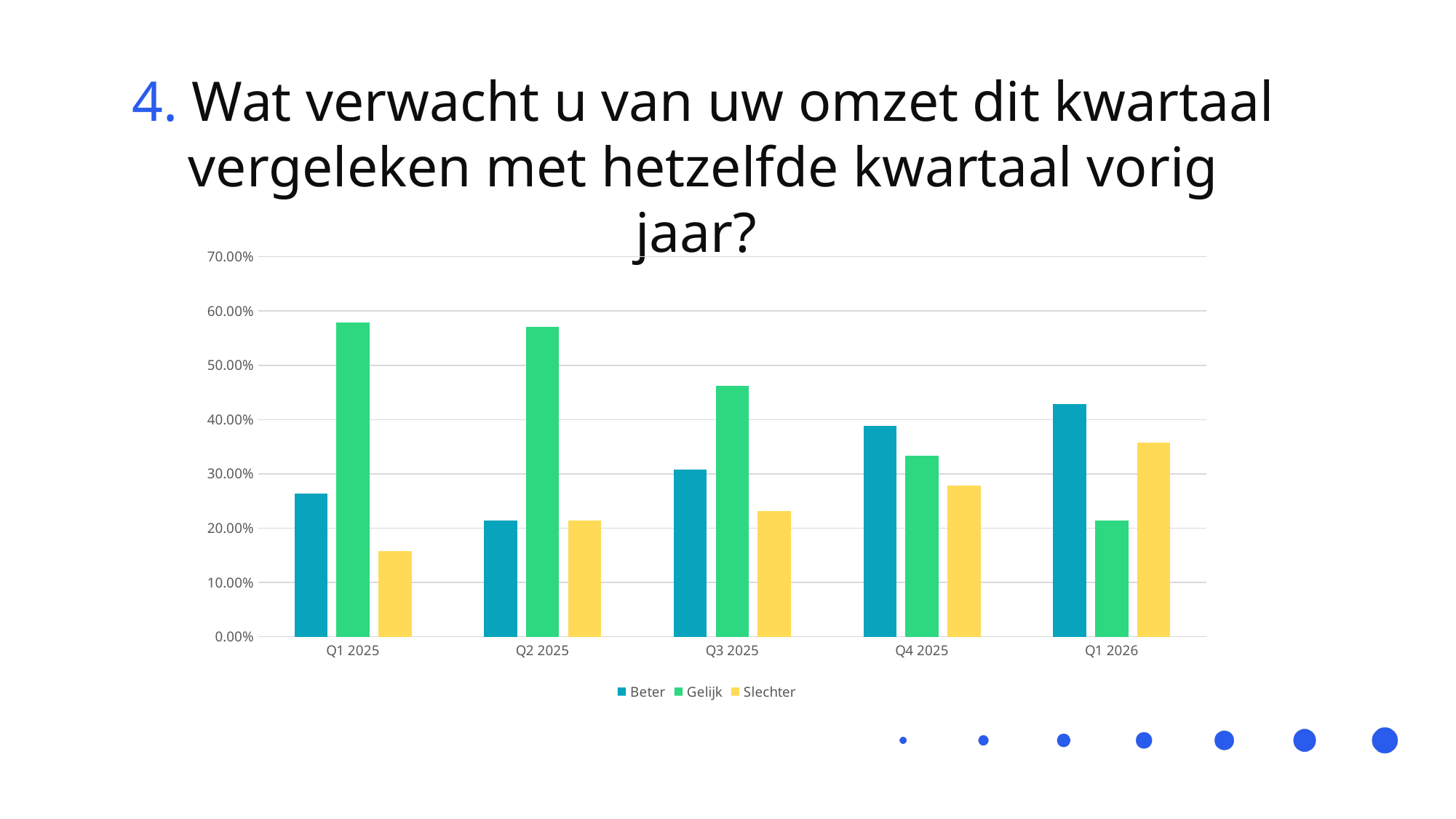
How many series does the chart's legend list? 3 In Q4 2025, which is larger: Beter or Gelijk? Beter Is the value for Gelijk in Q1 2025 greater or less than 50.00%? greater Which series has the lowest value in Q1 2025? Slechter What kind of chart is shown on the slide? bar chart What are the three entries in the chart's legend? Beter, Gelijk, Slechter Is the value for Beter in Q1 2026 greater or less than 40.00%? greater How many quarters are shown on the x axis of the chart? 5 Which series has the highest value in Q1 2026? Beter Do the values for Gelijk rise or fall from Q1 2025 to Q1 2026? fall Which series has the highest value in Q1 2025? Gelijk Is the value for Slechter in Q1 2025 greater or less than 20.00%? less